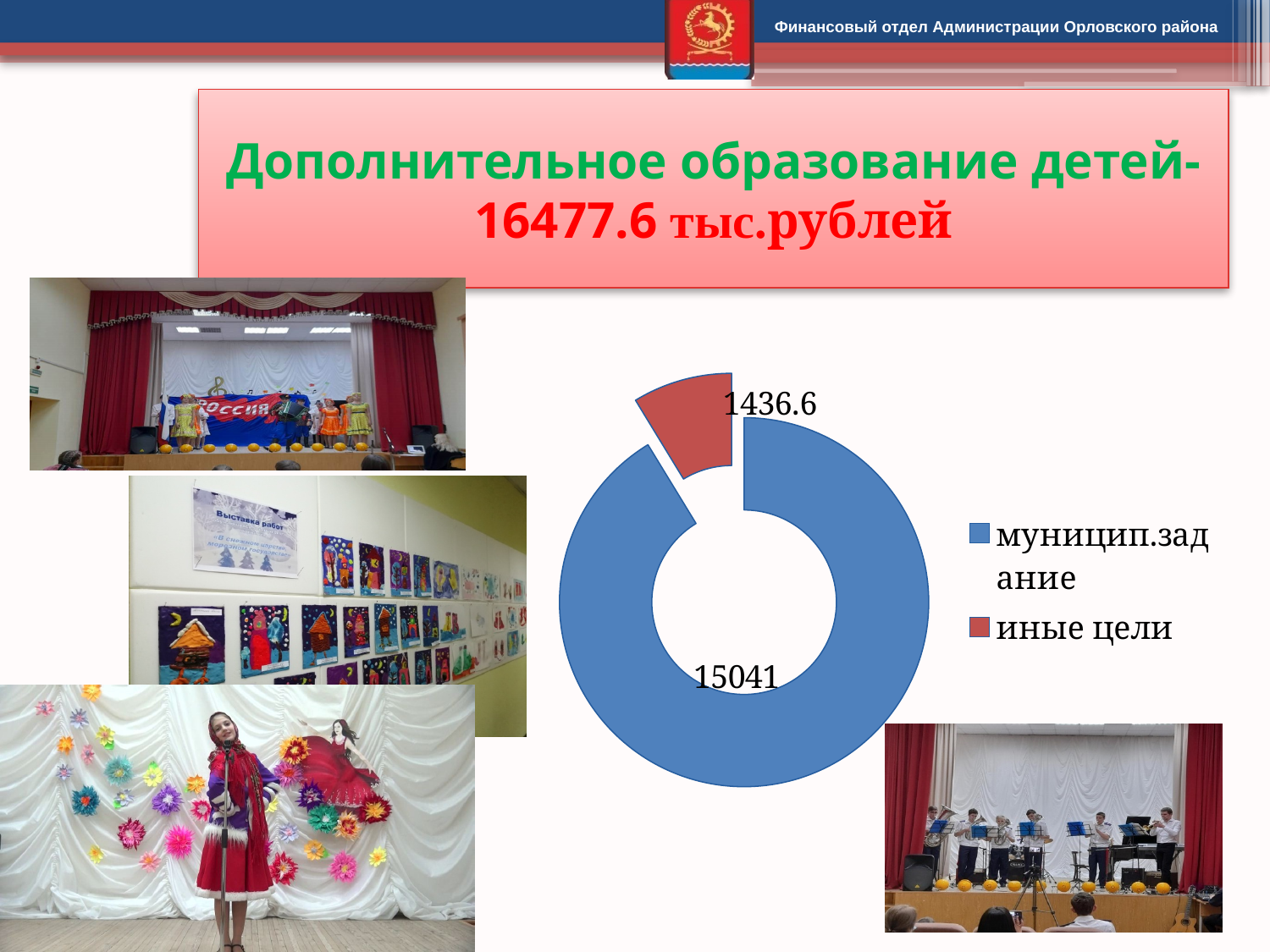
What colour is the slice for иные цели? red What is the difference between the values for муницип.задание and иные цели? 13604.4 What value is shown for муницип.задание? 15041 What value is shown for иные цели? 1436.6 Which is larger, the value for муницип.задание or the value for иные цели? муницип.задание Which category has the largest value? муницип.задание What total amount is stated in the slide title for Дополнительное образование детей? 16477.6 тыс.рублей How many categories does the chart show? 2 Which category has the smallest value? иные цели What is the total of the two values shown in the chart? 16477.6 How many entries does the legend list? 2 What kind of chart is shown on the slide? doughnut chart